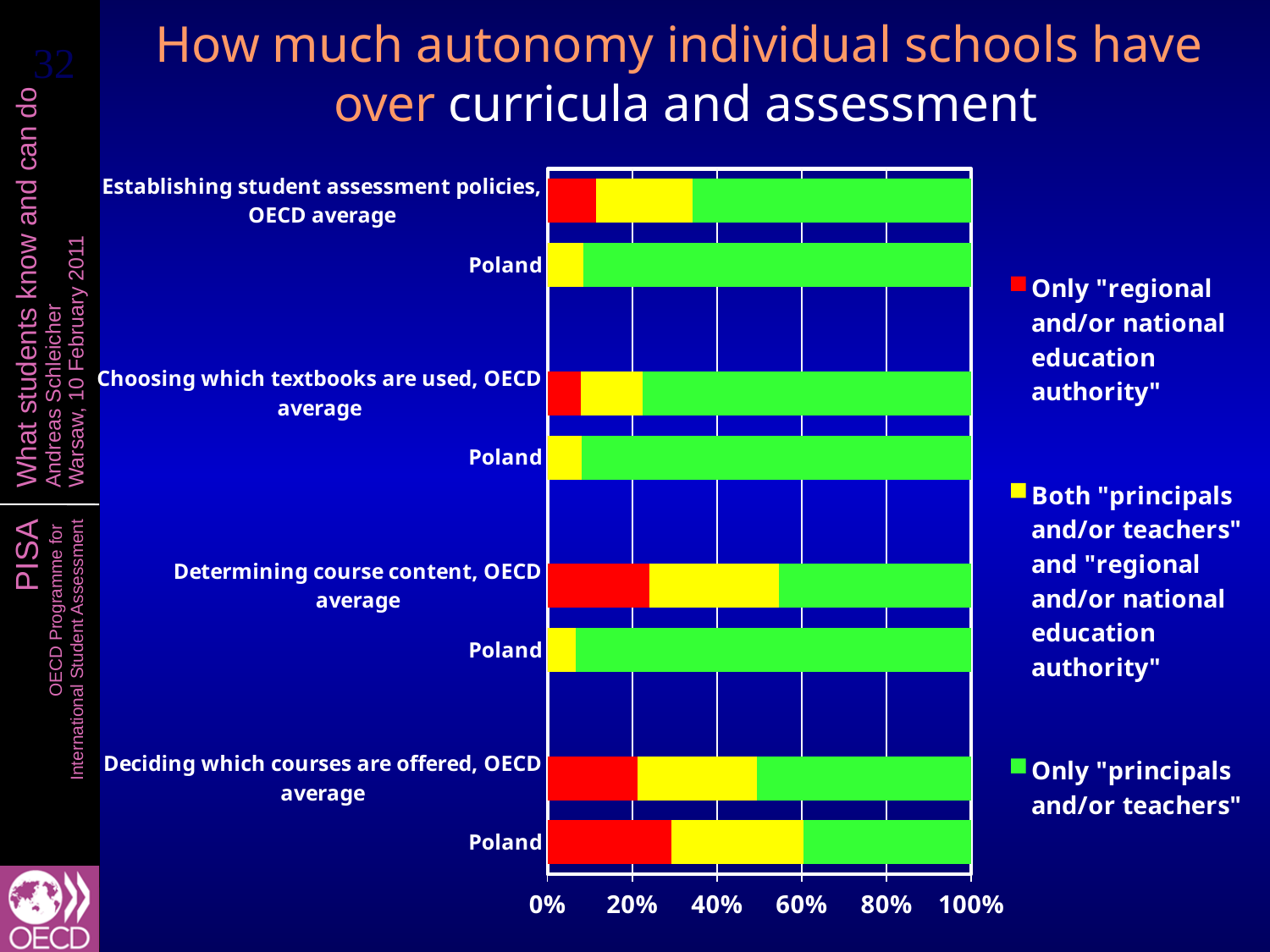
What is the highest value shown on the horizontal axis? 100% Is the red 'Only "regional and/or national education authority"' share for 'Determining course content, OECD average' greater or less than 20%? greater Which has the larger red 'Only "regional and/or national education authority"' segment: 'Determining course content, OECD average' or 'Choosing which textbooks are used, OECD average'? Determining course content, OECD average Which has the larger green 'Only "principals and/or teachers"' segment: Poland or the OECD average under 'Determining course content'? Poland What kind of chart is shown on the slide? Stacked bar chart Is the green 'Only "principals and/or teachers"' share for Poland under 'Deciding which courses are offered' greater or less than 60%? less How many series does the legend list? 3 How many bars are plotted in the chart? 8 Is the red 'Only "regional and/or national education authority"' share for 'Choosing which textbooks are used, OECD average' greater or less than 20%? less Which colour represents 'Only "principals and/or teachers"' in the legend? Green